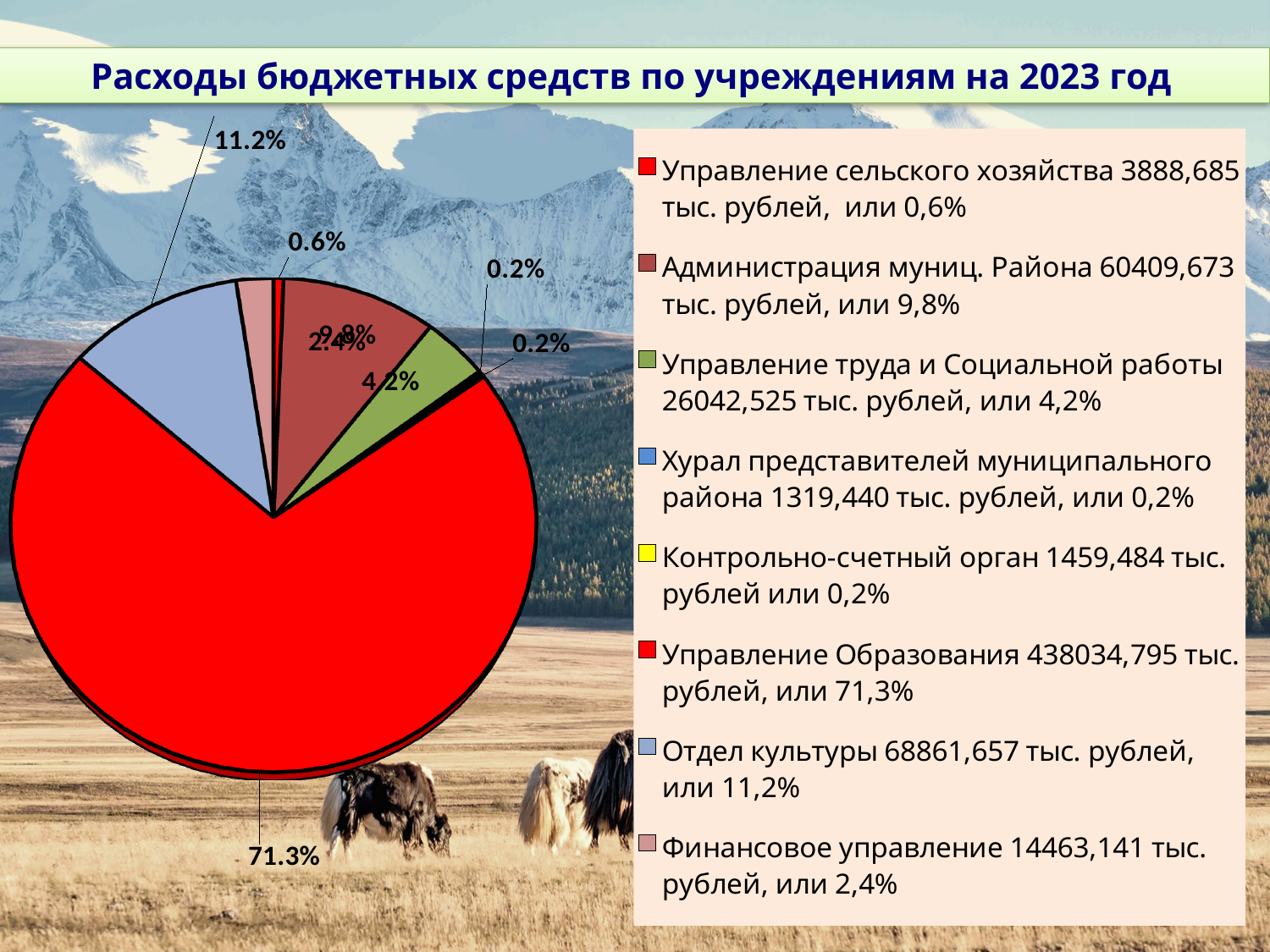
Which institution has the largest share of budget expenditures in the pie chart? Управление Образования What share of expenditures does Отдел культуры account for? 11.2% How many institutions are listed in the legend of the pie chart? 8 What is the difference in percentage points between the share of Управление Образования and the share of Отдел культуры? 60.1% What kind of chart is shown on the slide? pie chart What share of expenditures does Управление Образования account for? 71.3% Which has a larger share: Финансовое управление or Управление труда и Социальной работы? Управление труда и Социальной работы What share of expenditures does Администрация муниц. Района account for? 9.8% Which has a larger share: Отдел культуры or Администрация муниц. Района? Отдел культуры What is the title of the slide's chart? Расходы бюджетных средств по учреждениям на 2023 год